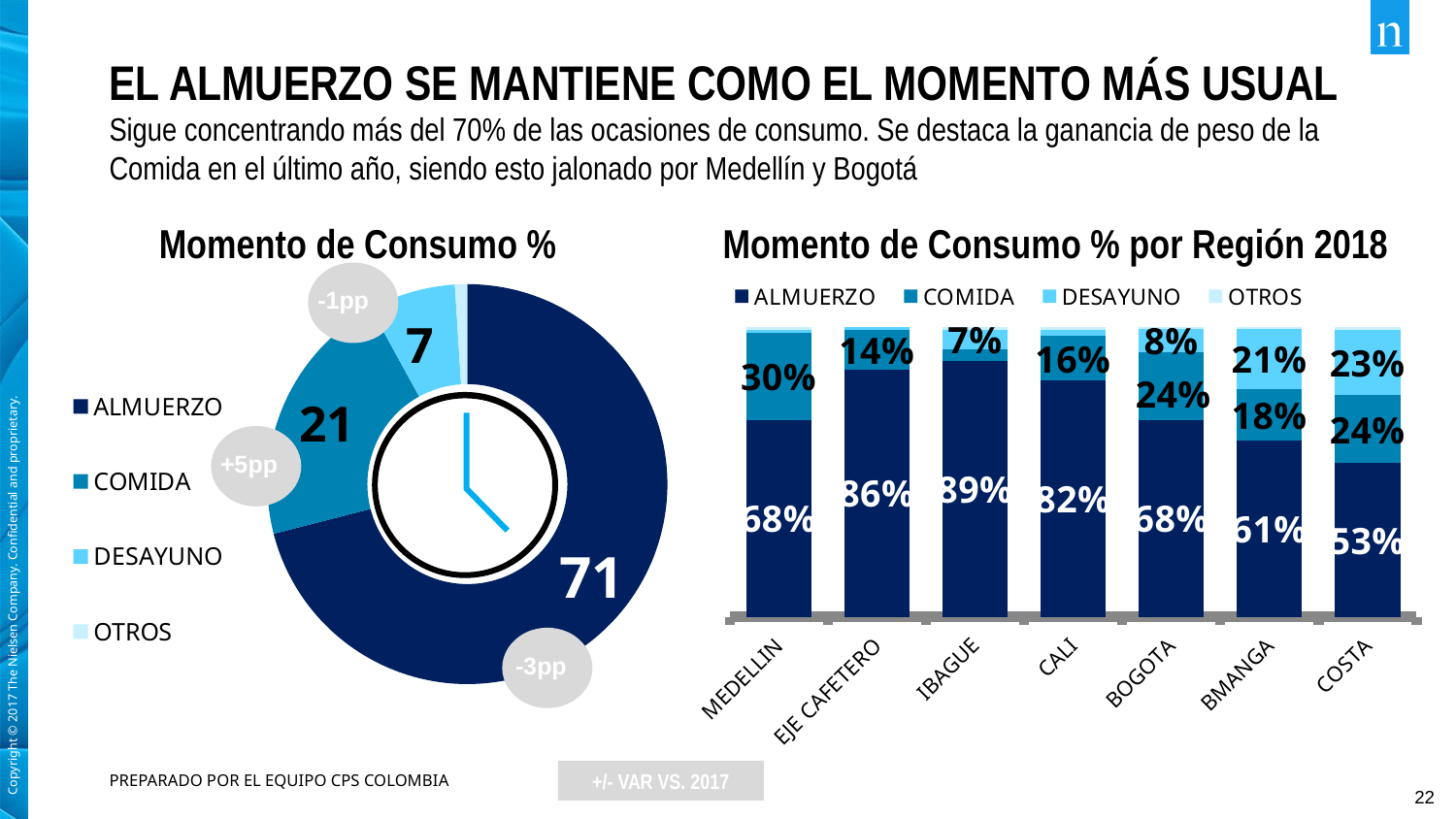
In the left chart 'Momento de Consumo %', what is the value for ALMUERZO? 71 In the right chart 'Momento de Consumo % por Región 2018', how many series does the legend list? 4 In the right chart 'Momento de Consumo % por Región 2018', how many regions are shown on the x axis? 7 In the right chart 'Momento de Consumo % por Región 2018', what is the COMIDA value for MEDELLIN? 30% What kind of chart is the left chart titled 'Momento de Consumo %'? Doughnut chart In the left chart 'Momento de Consumo %', what is the value for COMIDA? 21 What kind of chart is the right chart titled 'Momento de Consumo % por Región 2018'? Stacked bar chart In the right chart 'Momento de Consumo % por Región 2018', which region has the lowest ALMUERZO value? COSTA In the right chart 'Momento de Consumo % por Región 2018', which region has the higher COMIDA value, MEDELLIN or CALI? MEDELLIN In the right chart 'Momento de Consumo % por Región 2018', what is the ALMUERZO value for IBAGUE? 89% In the left chart 'Momento de Consumo %', which category has the largest share? ALMUERZO In the left chart 'Momento de Consumo %', what is the difference between the ALMUERZO and COMIDA values? 50